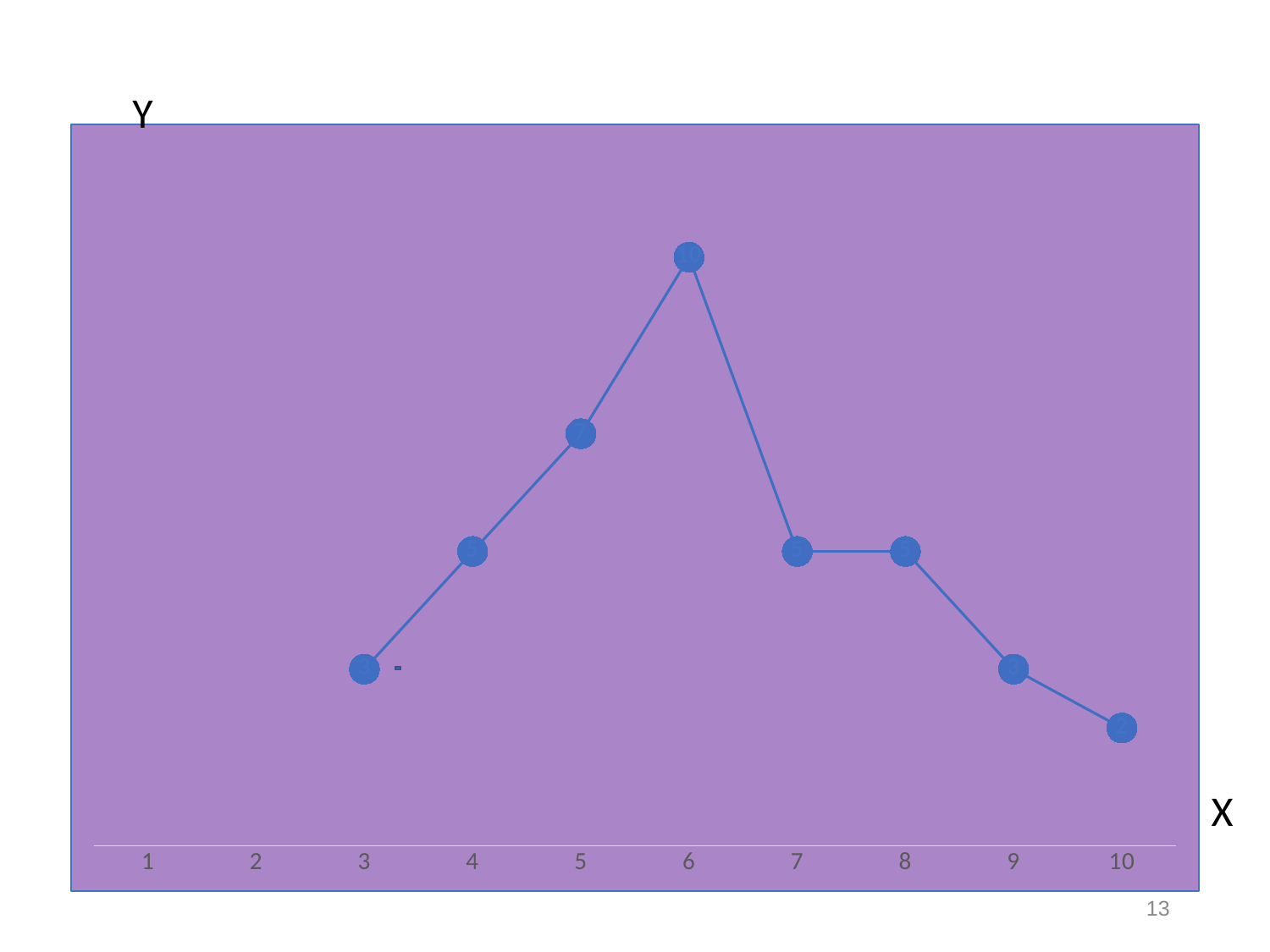
Which has the larger value, the point at x = 3 or the point at x = 10? x = 3 What kind of chart is shown on the slide? Line chart Which has the larger value, the point at x = 5 or the point at x = 4? x = 5 What is the label of the vertical axis? Y Do the values rise or fall from x = 8 to x = 10? Fall What is the label of the horizontal axis? X Do the values rise or fall from x = 3 to x = 6? Rise Which has the larger value, the point at x = 6 or the point at x = 7? x = 6 How many tick labels are shown on the x axis? 10 At which x value does the line reach its highest point? 6 How many data points are plotted on the line? 8 At which x value does the line reach its lowest point? 10